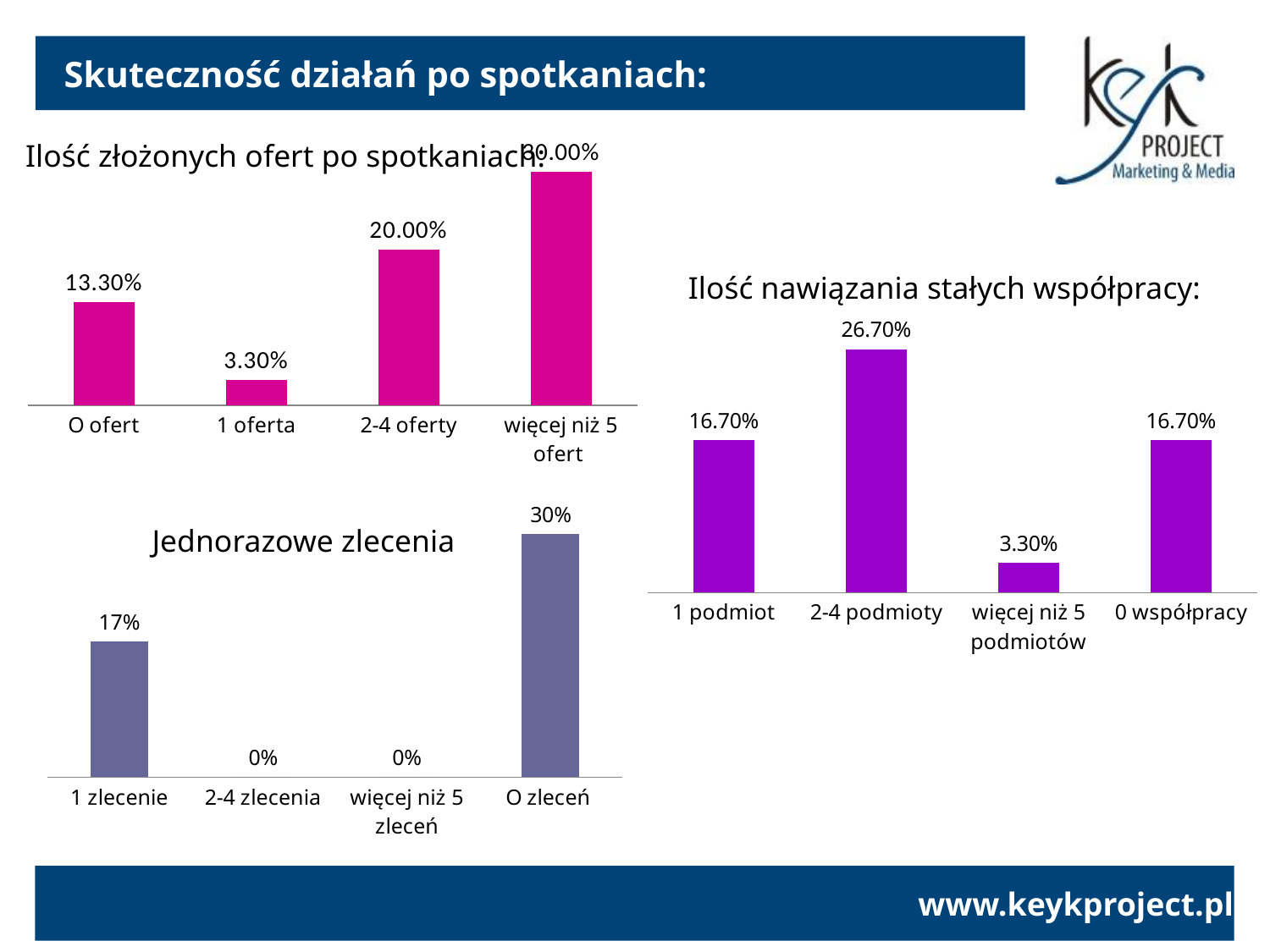
In the chart 'Jednorazowe zlecenia', how many categories have a value of 0%? 2 In the chart 'Jednorazowe zlecenia', what is the value for '1 zlecenie'? 17% In the chart 'Ilość nawiązania stałych współpracy', what is the difference between '2-4 podmioty' and '1 podmiot'? 10.00% In the chart 'Jednorazowe zlecenia', which category has the highest value? O zleceń What type of chart is 'Jednorazowe zlecenia'? Bar chart In the chart 'Ilość złożonych ofert po spotkaniach', what is the value for '2-4 oferty'? 20.00% In the chart 'Ilość nawiązania stałych współpracy', what is the value for '2-4 podmioty'? 26.70% In the chart 'Ilość nawiązania stałych współpracy', how many categories are shown? 4 In the chart 'Ilość złożonych ofert po spotkaniach', which category has the highest value? więcej niż 5 ofert In the chart 'Ilość nawiązania stałych współpracy', which category has the lowest value? więcej niż 5 podmiotów In the chart 'Ilość złożonych ofert po spotkaniach', what is the value for '1 oferta'? 3.30% In the chart 'Ilość złożonych ofert po spotkaniach', what is the difference between 'O ofert' and '1 oferta'? 10.00%